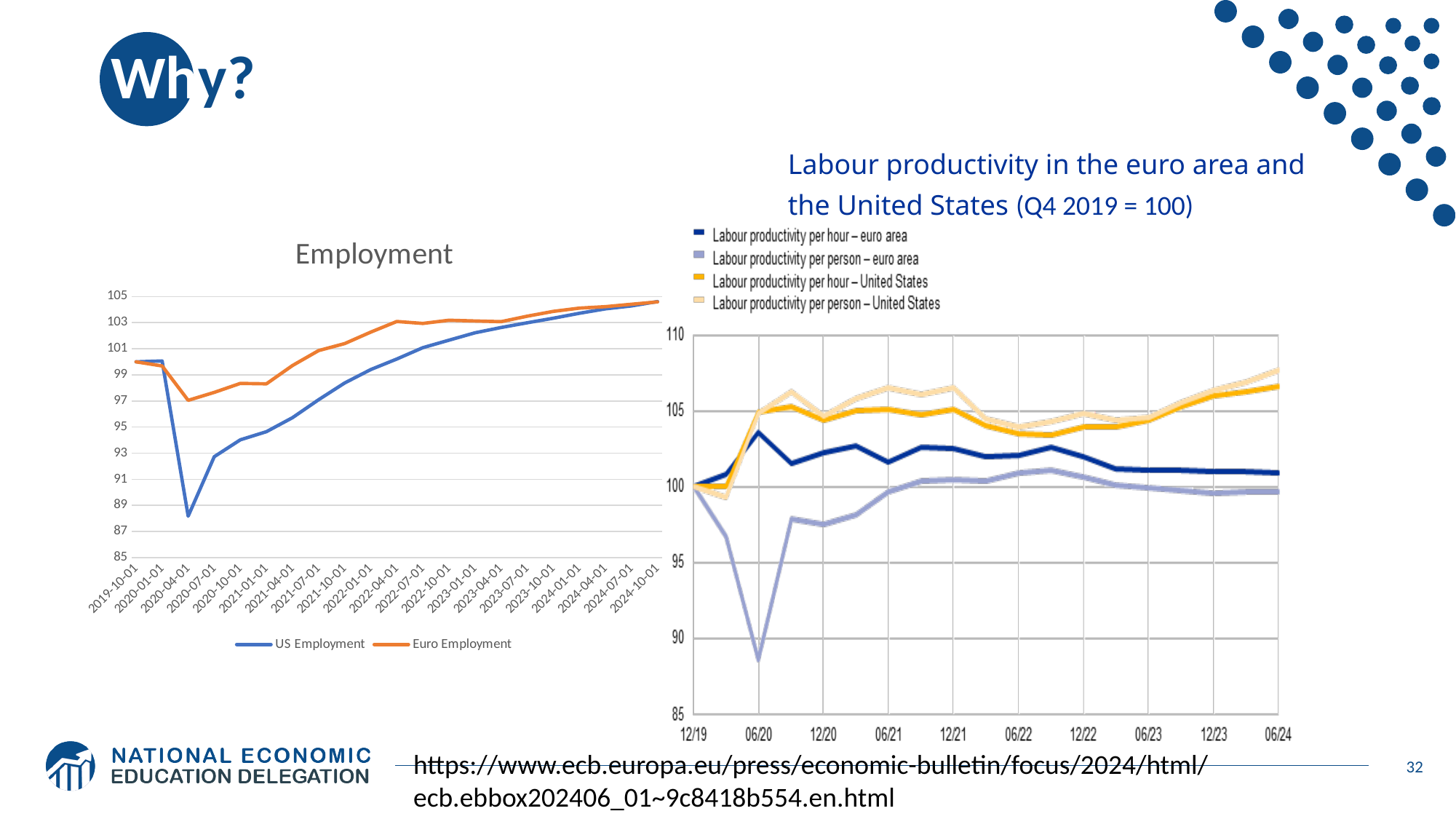
In the Employment chart, which series is higher at 2020-04-01, US Employment or Euro Employment? Euro Employment What base period is given in the title of the Labour productivity chart? Q4 2019 = 100 In the Employment chart, at which date is US Employment lowest? 2020-04-01 How many series does the legend of the Employment chart list? 2 How many series does the legend of the Labour productivity chart list? 4 In the Employment chart, is the value for US Employment at 2020-04-01 greater or less than 91? less How many dates are labelled on the x axis of the Employment chart? 21 In the Labour productivity chart, is the value for Labour productivity per person – euro area at 06/20 greater or less than 90? less In the Employment chart, does US Employment rise or fall from 2020-04-01 to 2024-10-01? rise In the Employment chart, is the value for Euro Employment at 2020-04-01 greater or less than 95? greater What kind of chart is the Employment chart on the left? line chart